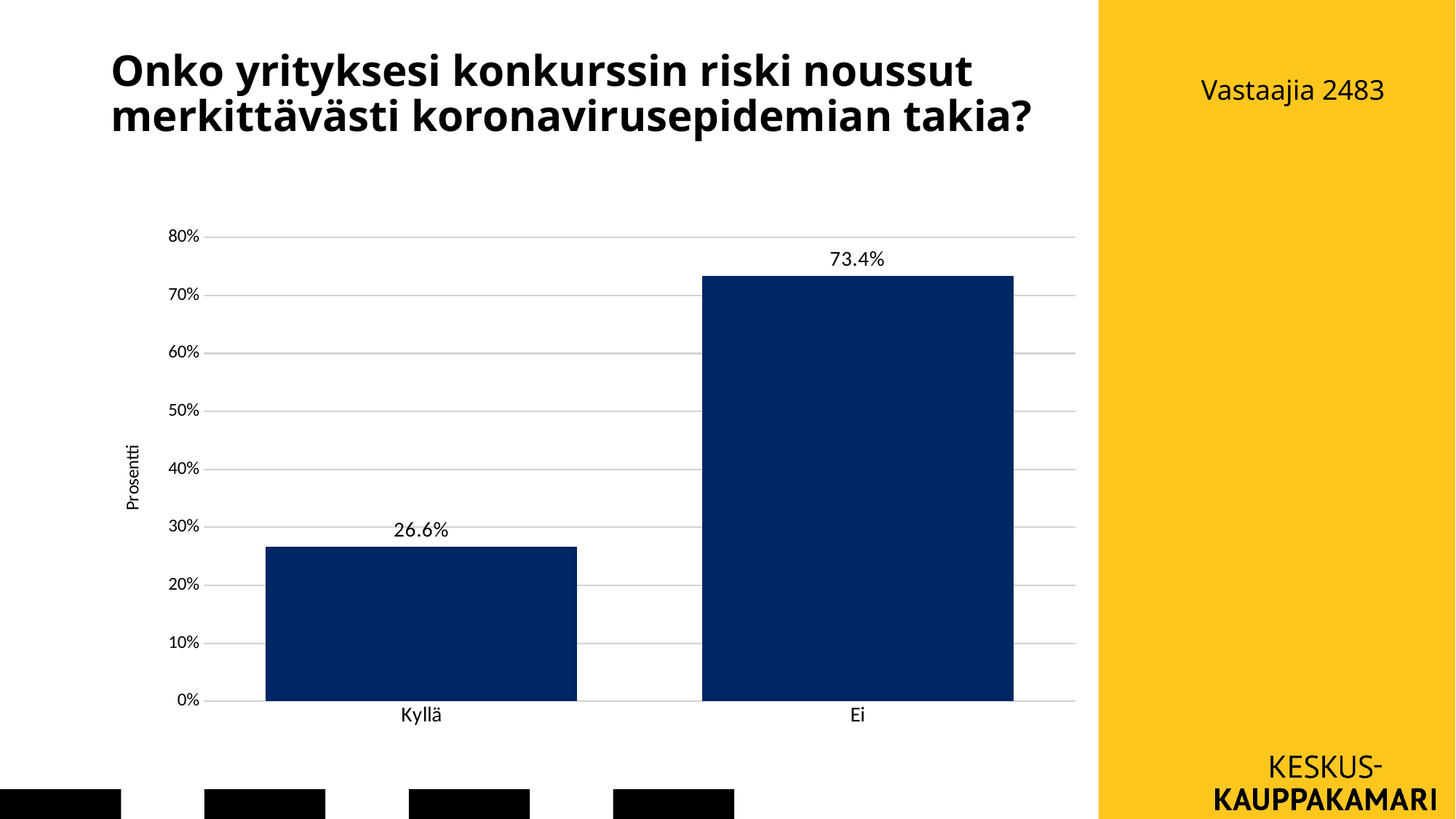
Which is larger, the value for Kyllä or the value for Ei? Ei What is the difference between the values for Ei and Kyllä? 46.8% Which category has the lowest value? Kyllä Which category has the highest value? Ei Is the value for Ei greater or less than 70%? greater How many categories are shown on the x axis? 2 What kind of chart is shown on the slide? bar chart What is the label of the y axis? Prosentti What is the value for Ei? 73.4% What is the highest value shown on the y axis? 80% What is the value for Kyllä? 26.6% Is the value for Kyllä greater or less than 30%? less